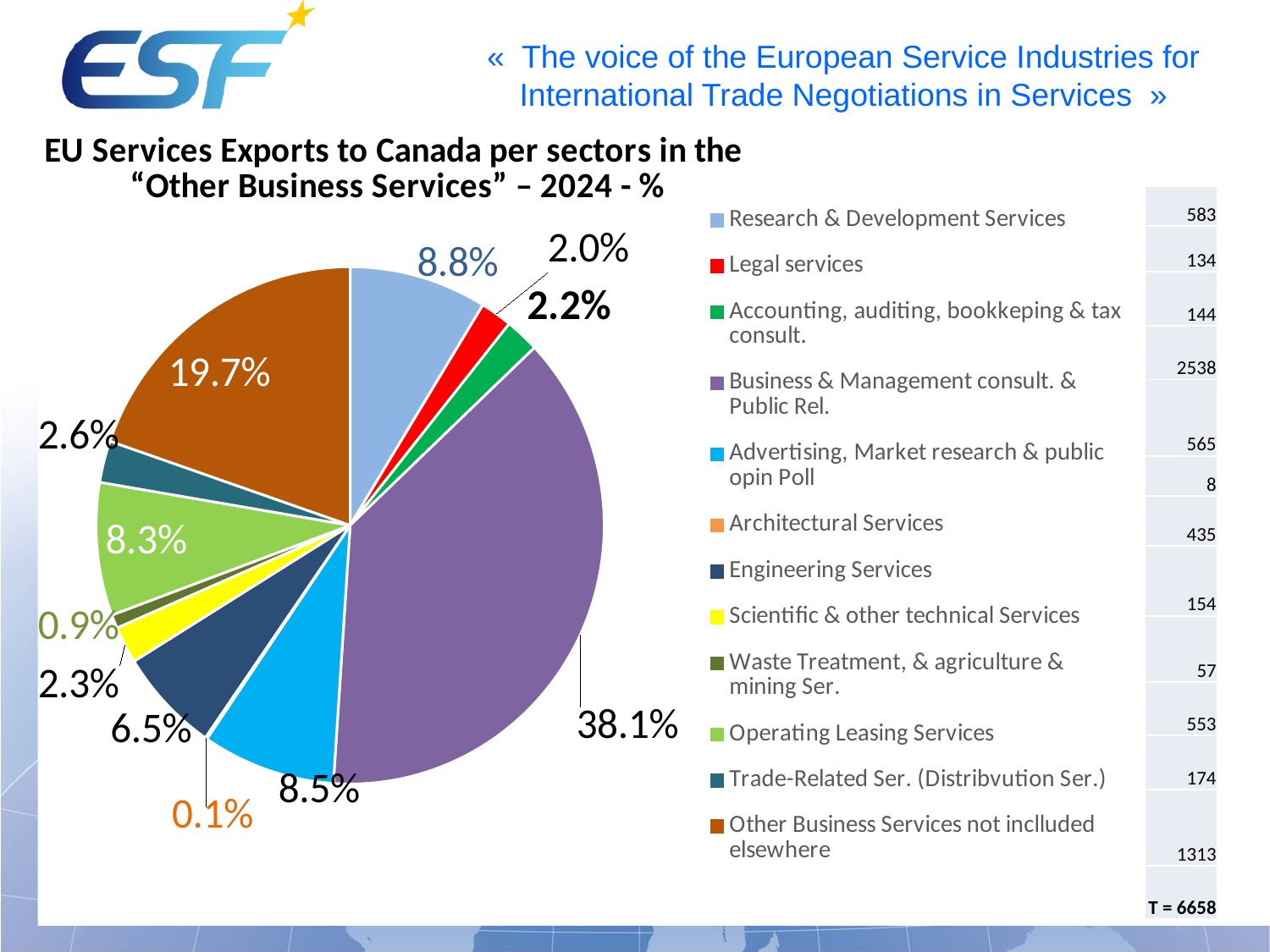
What type of chart is shown on the slide? Pie chart What percentage is shown for Engineering Services? 6.5% Which has a larger share: Advertising, Market research & public opin Poll or Operating Leasing Services? Advertising, Market research & public opin Poll Which sector has the largest share of the pie? Business & Management consult. & Public Rel. What is the difference in percentage points between Other Business Services not included elsewhere and Research & Development Services? 10.9 What percentage is shown for Research & Development Services? 8.8% What percentage is shown for Other Business Services not included elsewhere? 19.7% What percentage is shown for Legal services? 2.0% What is the title of the chart? EU Services Exports to Canada per sectors in the "Other Business Services" – 2024 - % How many sectors are shown in the pie chart? 12 Which sector has the smallest share of the pie? Architectural Services What share of the pie does Business & Management consult. & Public Rel. account for? 38.1%